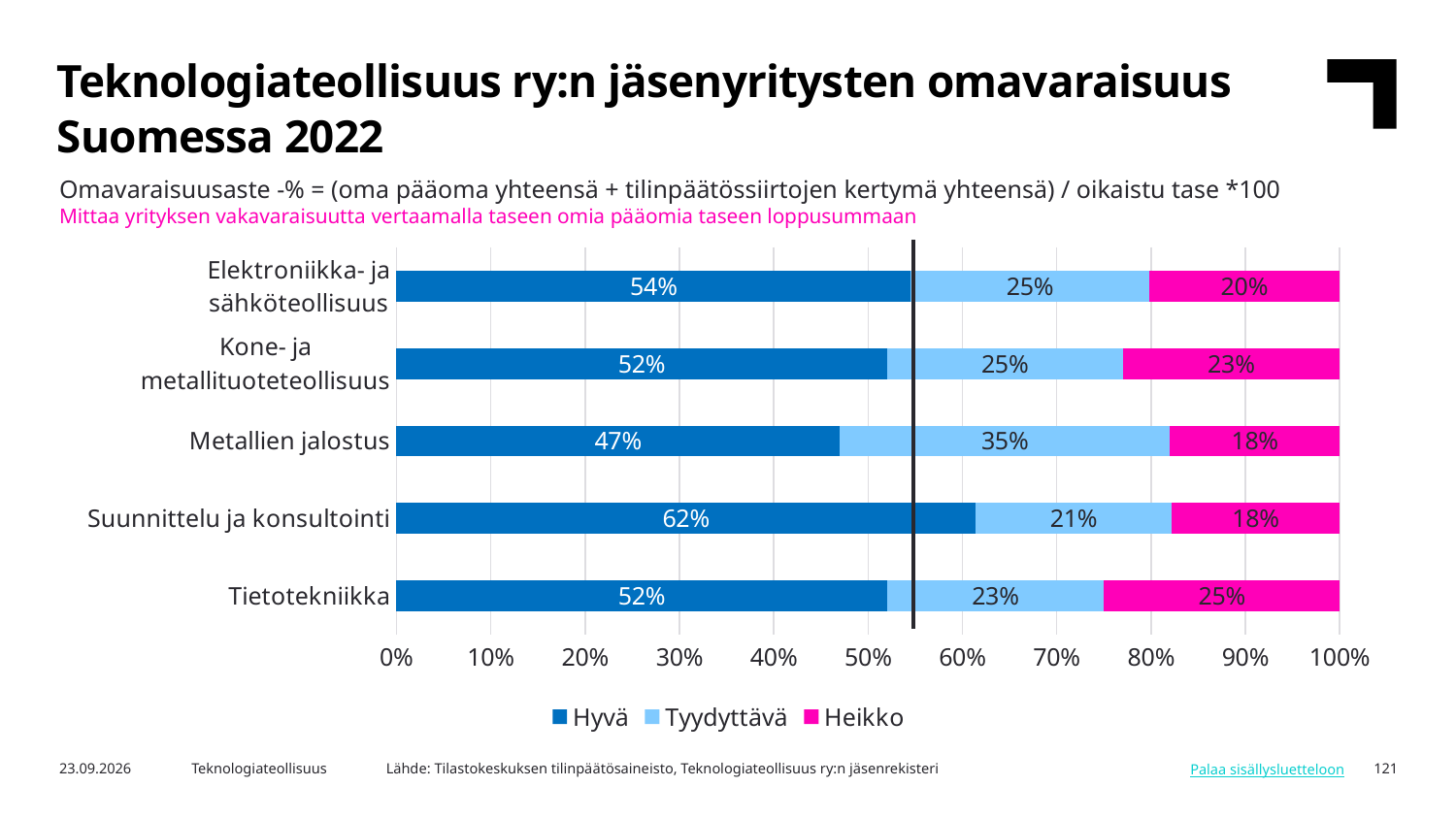
Which series is shown in magenta in the legend? Heikko What is the Hyvä value for Suunnittelu ja konsultointi? 62% What is the Tyydyttävä value for Metallien jalostus? 35% How many categories are shown in the chart? 5 Which category has the highest Hyvä value? Suunnittelu ja konsultointi Which is larger, the Heikko value for Kone- ja metallituoteteollisuus or the Heikko value for Metallien jalostus? Kone- ja metallituoteteollisuus Which category has the lowest Hyvä value? Metallien jalostus What kind of chart is shown on the slide? Stacked bar chart What is the difference between the Hyvä values for Suunnittelu ja konsultointi and Metallien jalostus? 15% What is the Hyvä value for Elektroniikka- ja sähköteollisuus? 54% How many series does the legend list? 3 What is the Heikko value for Tietotekniikka? 25%